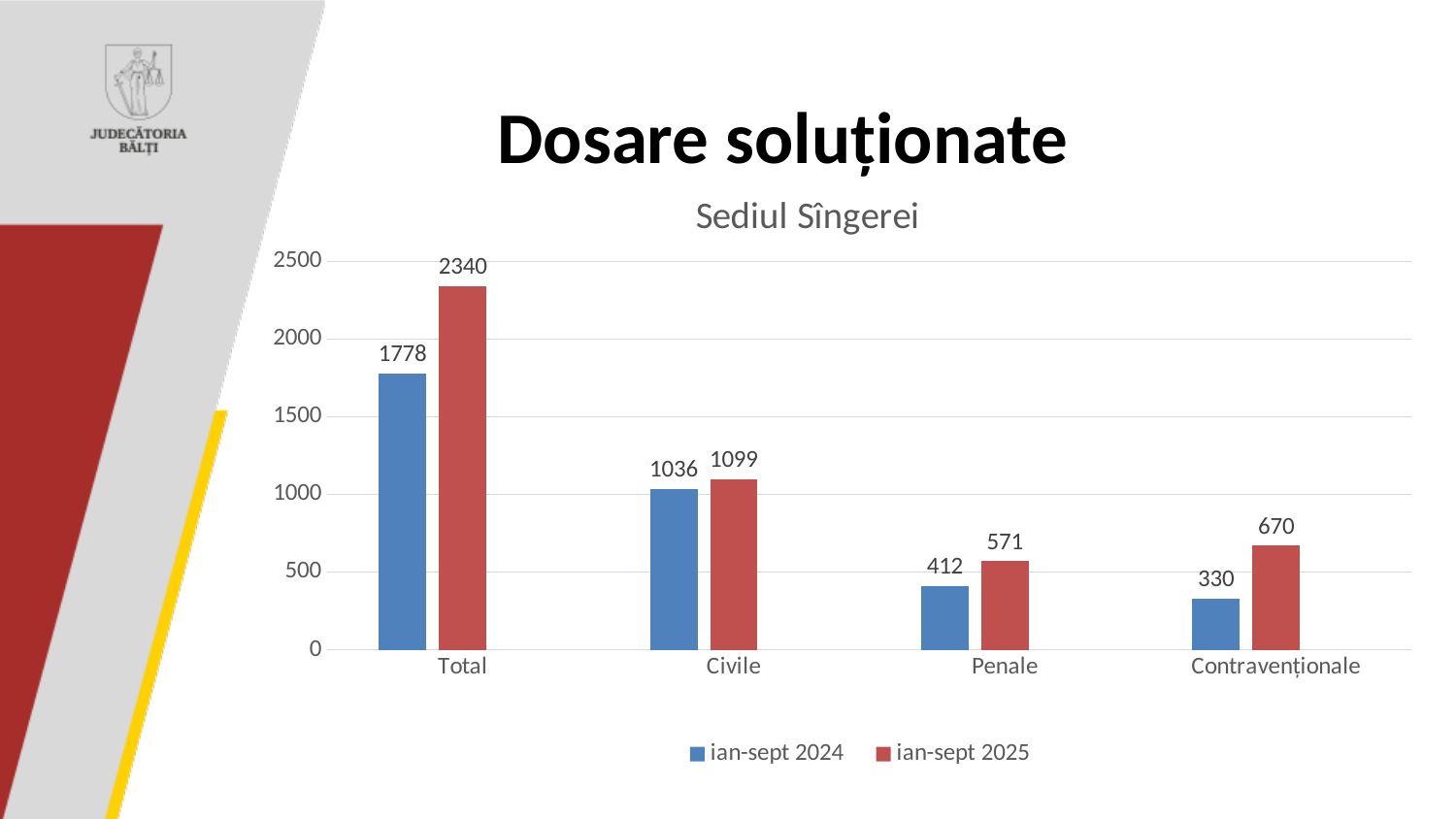
How many categories are shown on the x axis? 4 What is the difference between the ian-sept 2025 and ian-sept 2024 values for Total? 562 What is the value for Total in the ian-sept 2025 series? 2340 What is the difference between the ian-sept 2025 and ian-sept 2024 values for Penale? 159 What kind of chart is shown on the slide? Bar chart How many series does the legend list? 2 What is the subtitle shown above the chart? Sediul Sîngerei Which category has the highest value in the ian-sept 2025 series? Total What is the value for Contravenționale in the ian-sept 2025 series? 670 Which category has the lowest value in the ian-sept 2024 series? Contravenționale What is the value for Civile in the ian-sept 2024 series? 1036 Which is larger: the ian-sept 2024 value for Penale or the ian-sept 2024 value for Contravenționale? Penale